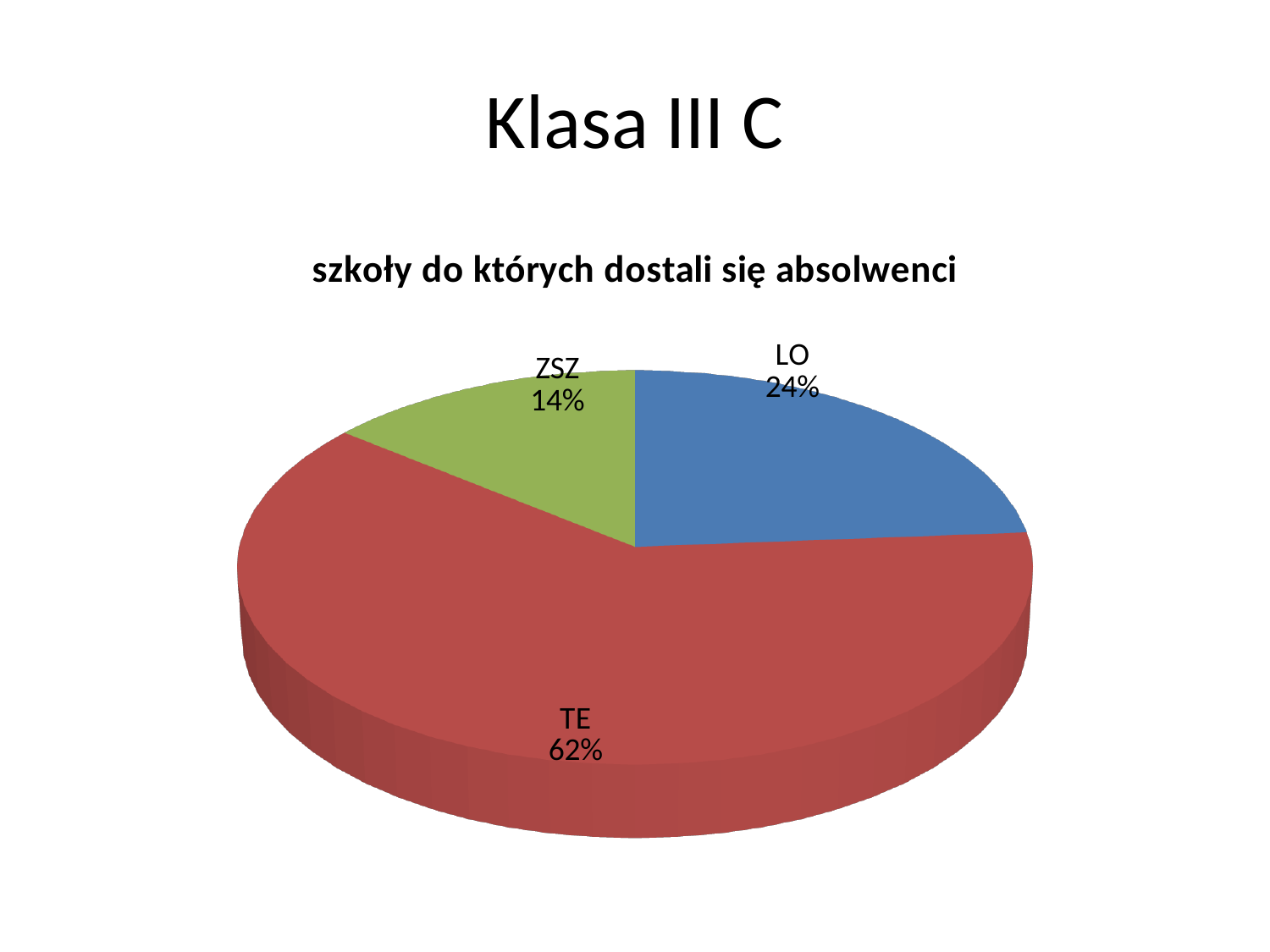
What share of the pie does LO have? 24% What is the difference in percentage points between TE and LO? 38 What is the difference in percentage points between LO and ZSZ? 10 How many slices does the pie chart have? 3 Which category has the largest slice? TE What is the title of the chart? szkoły do których dostali się absolwenci Which category has the smallest slice? ZSZ What share of the pie does ZSZ have? 14% What colour is the TE slice? red Which is larger, the share for LO or the share for ZSZ? LO What share of the pie does TE have? 62% What type of chart is shown on the slide? pie chart